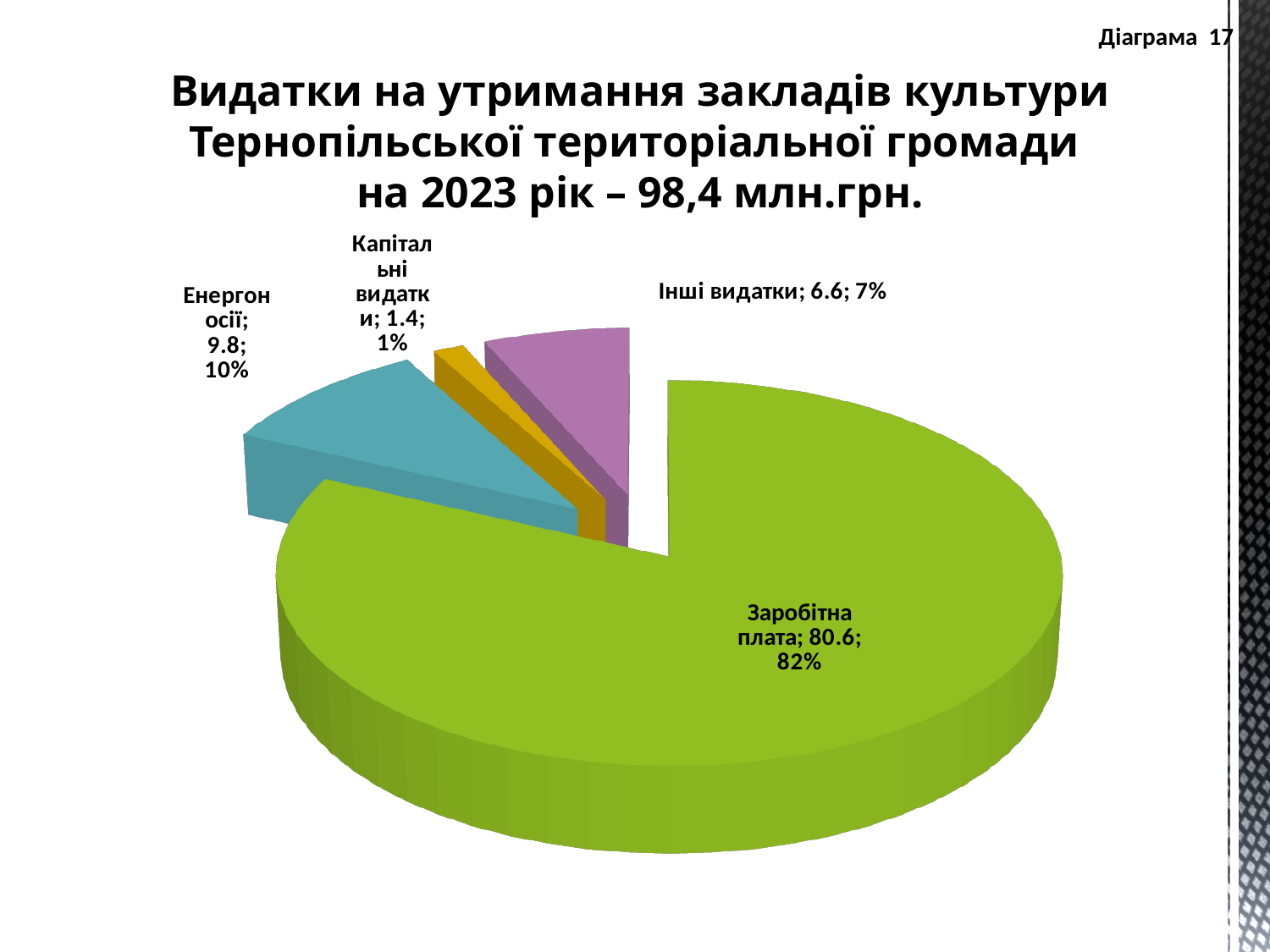
What kind of chart is shown on the slide? Pie chart How many slices does the pie chart have? 4 What is the value shown for Енергоносії? 9.8 What is the value shown for Інші видатки? 6.6 Which is larger, Енергоносії or Інші видатки? Енергоносії What share of the pie does Заробітна плата represent? 82% What is the difference between the values for Енергоносії and Інші видатки? 3.2 Which category has the smallest slice of the pie? Капітальні видатки Which category has the largest slice of the pie? Заробітна плата What is the value shown for Заробітна плата? 80.6 What share of the pie does Енергоносії represent? 10% What is the value shown for Капітальні видатки? 1.4